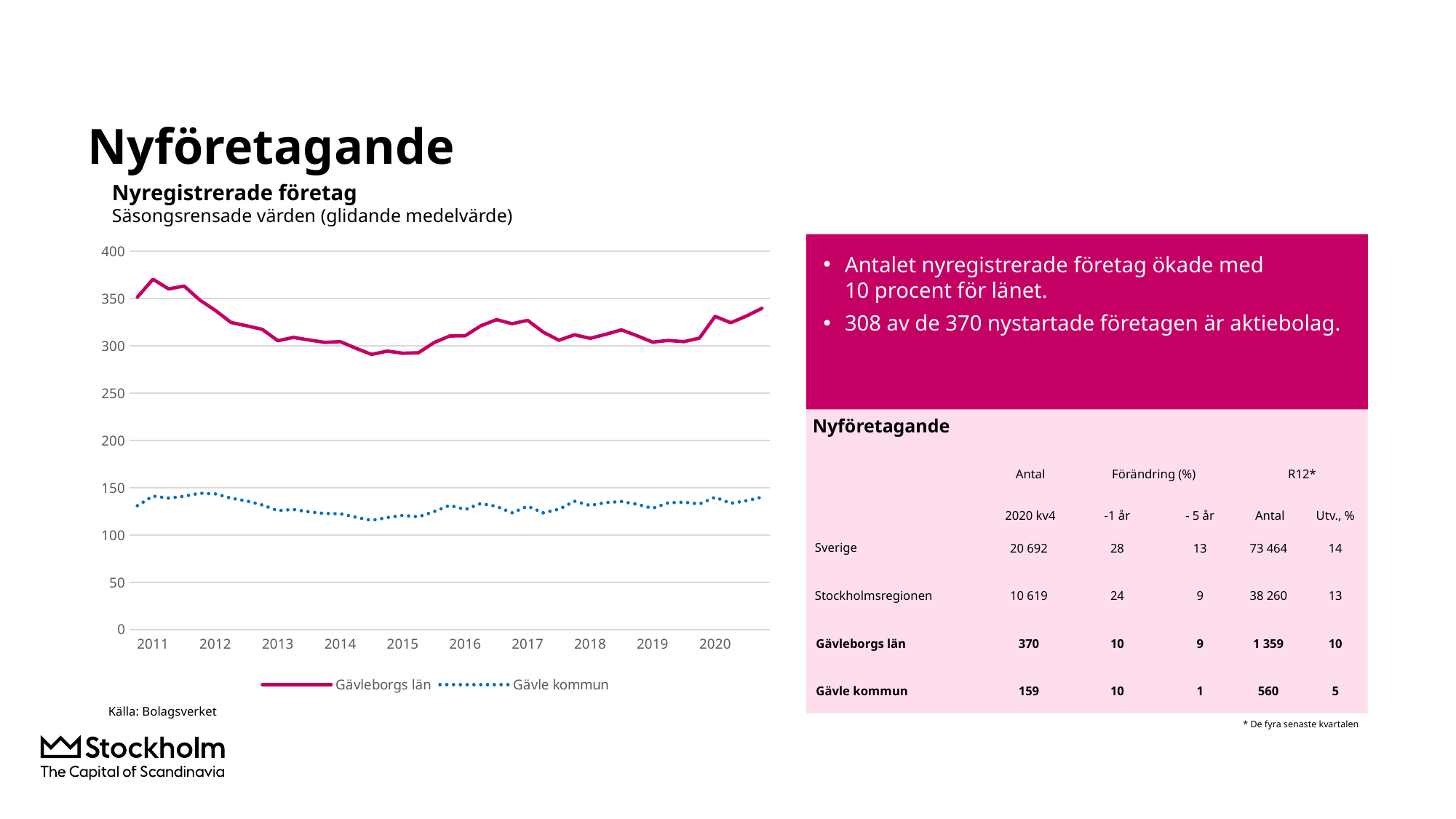
Is the value for Gävle kommun in 2015 greater or less than 200? less Is the value for Gävleborgs län in 2014 greater or less than 350? less Does the Gävleborgs län line rise or fall between 2011 and 2014? fall What kind of chart is shown on the slide? line chart Is the value for Gävleborgs län at the end of 2020 greater or less than 300? greater How many years are labelled on the x axis of the chart? 10 What are the two series named in the chart legend? Gävleborgs län and Gävle kommun What is the title of the chart? Nyregistrerade företag Does the Gävleborgs län line rise or fall between 2019 and the end of 2020? rise Which series has the higher values throughout the chart, Gävleborgs län or Gävle kommun? Gävleborgs län How many series does the chart legend list? 2